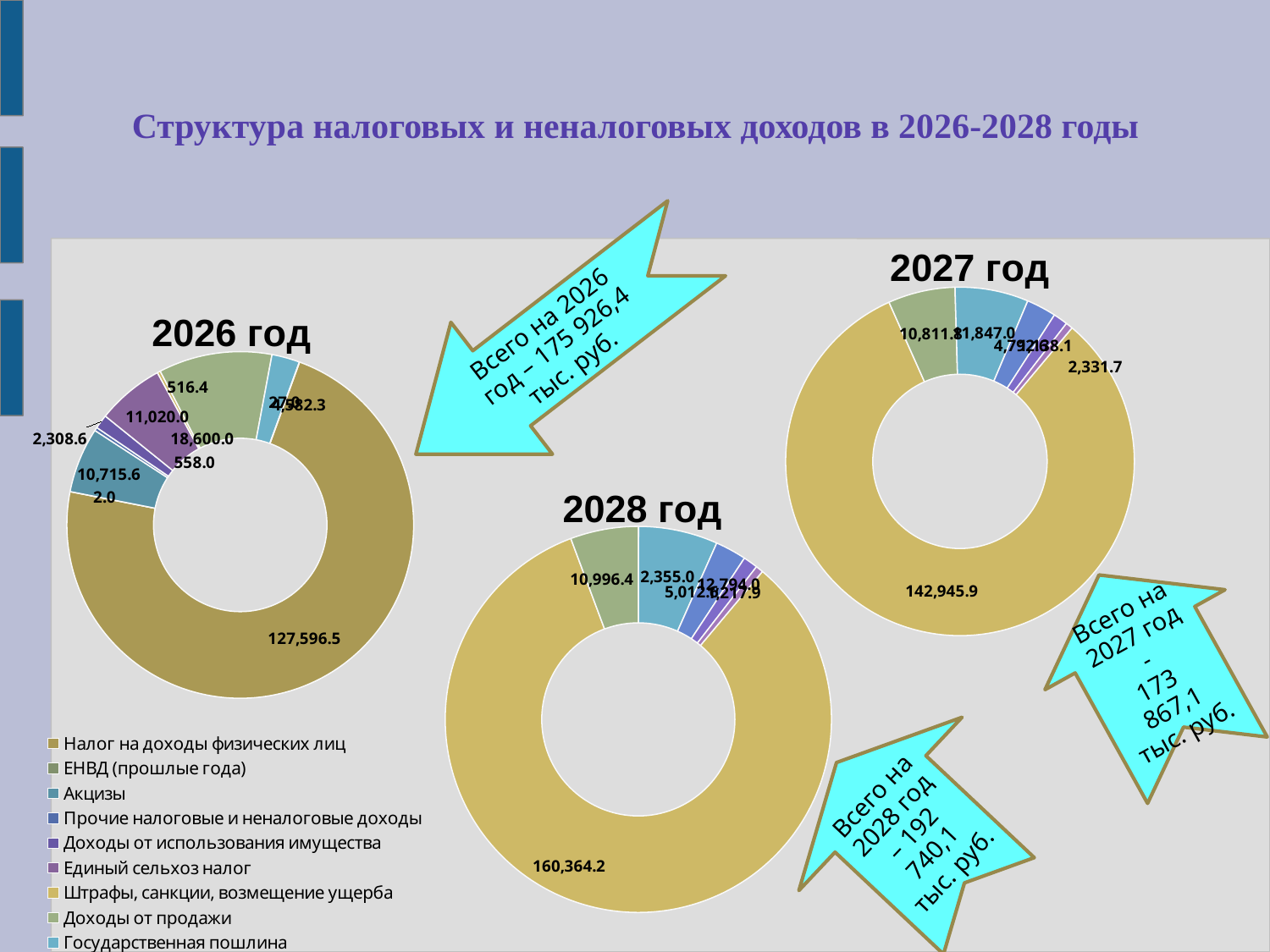
What is the difference between the largest slice in the 2028 год chart (160,364.2) and the largest slice in the 2026 год chart (127,596.5)? 32,767.7 What is the first entry in the legend? Налог на доходы физических лиц What kind of chart is used for each year on this slide? doughnut chart How many charts are shown on the slide? 3 Which chart has the larger biggest slice, 2026 год or 2028 год? 2028 год What is the difference between the largest slice in the 2027 год chart (142,945.9) and the largest slice in the 2026 год chart (127,596.5)? 15,349.4 How many entries does the legend list? 9 In the 2026 год chart, what is the smallest labelled value? 2.0 In the 2026 год chart, what is the value of the largest slice? 127,596.5 What is the title of the slide? Структура налоговых и неналоговых доходов в 2026-2028 годы In the 2028 год chart, what is the value of the largest slice? 160,364.2 In the 2027 год chart, what is the value of the largest slice? 142,945.9